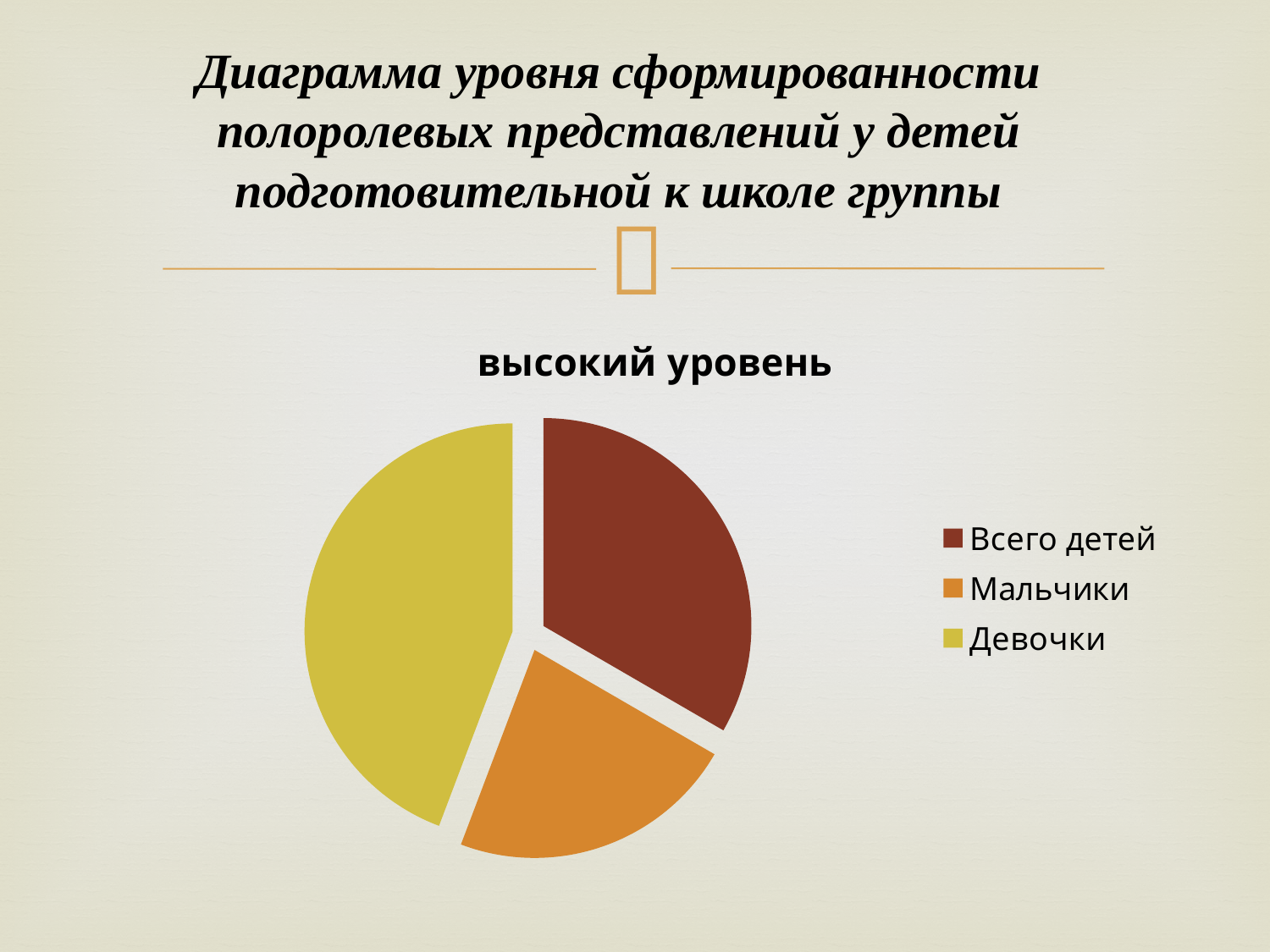
Which category has the smallest slice of the pie? Мальчики What is the title of the chart? высокий уровень Which slice is larger, Всего детей or Мальчики? Всего детей Which category has the largest slice of the pie? Девочки Which colour represents Девочки in the pie chart? yellow How many entries does the legend list? 3 Which slice is larger, Девочки or Мальчики? Девочки How many slices does the pie chart have? 3 What kind of chart is shown on the slide? pie chart